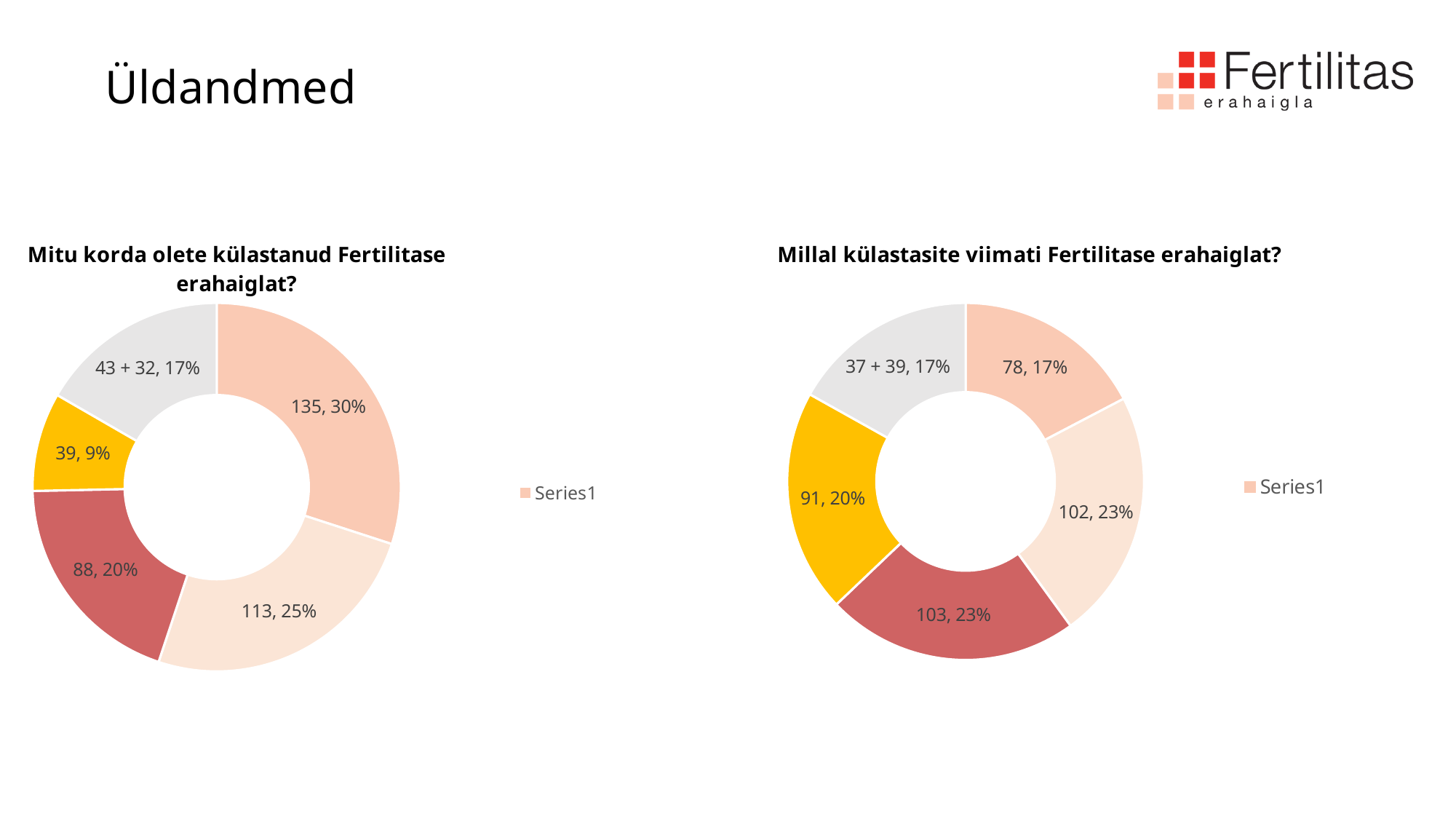
In the left chart "Mitu korda olete külastanud Fertilitase erahaiglat?", what is the data label on the grey slice? 43 + 32, 17% In the right chart "Millal külastasite viimati Fertilitase erahaiglat?", what share of the total does the red slice represent? 23% In the right chart "Millal külastasite viimati Fertilitase erahaiglat?", what is the data label on the yellow slice? 91, 20% In the right chart "Millal külastasite viimati Fertilitase erahaiglat?", which slice has the larger value, the red slice or the yellow slice? the red slice In the left chart "Mitu korda olete külastanud Fertilitase erahaiglat?", what is the data label of the largest slice? 135, 30% How many slices does the right chart "Millal külastasite viimati Fertilitase erahaiglat?" have? 5 What kind of chart is the left chart titled "Mitu korda olete külastanud Fertilitase erahaiglat?"? doughnut chart In the left chart "Mitu korda olete külastanud Fertilitase erahaiglat?", what is the difference between the value of the largest slice (135) and the second-largest slice (113)? 22 In the left chart "Mitu korda olete külastanud Fertilitase erahaiglat?", what is the data label of the smallest slice? 39, 9% What is the legend entry shown next to the right chart "Millal külastasite viimati Fertilitase erahaiglat?"? Series1 How many series does the legend of the left chart "Mitu korda olete külastanud Fertilitase erahaiglat?" list? 1 How many slices does the left chart "Mitu korda olete külastanud Fertilitase erahaiglat?" have? 5